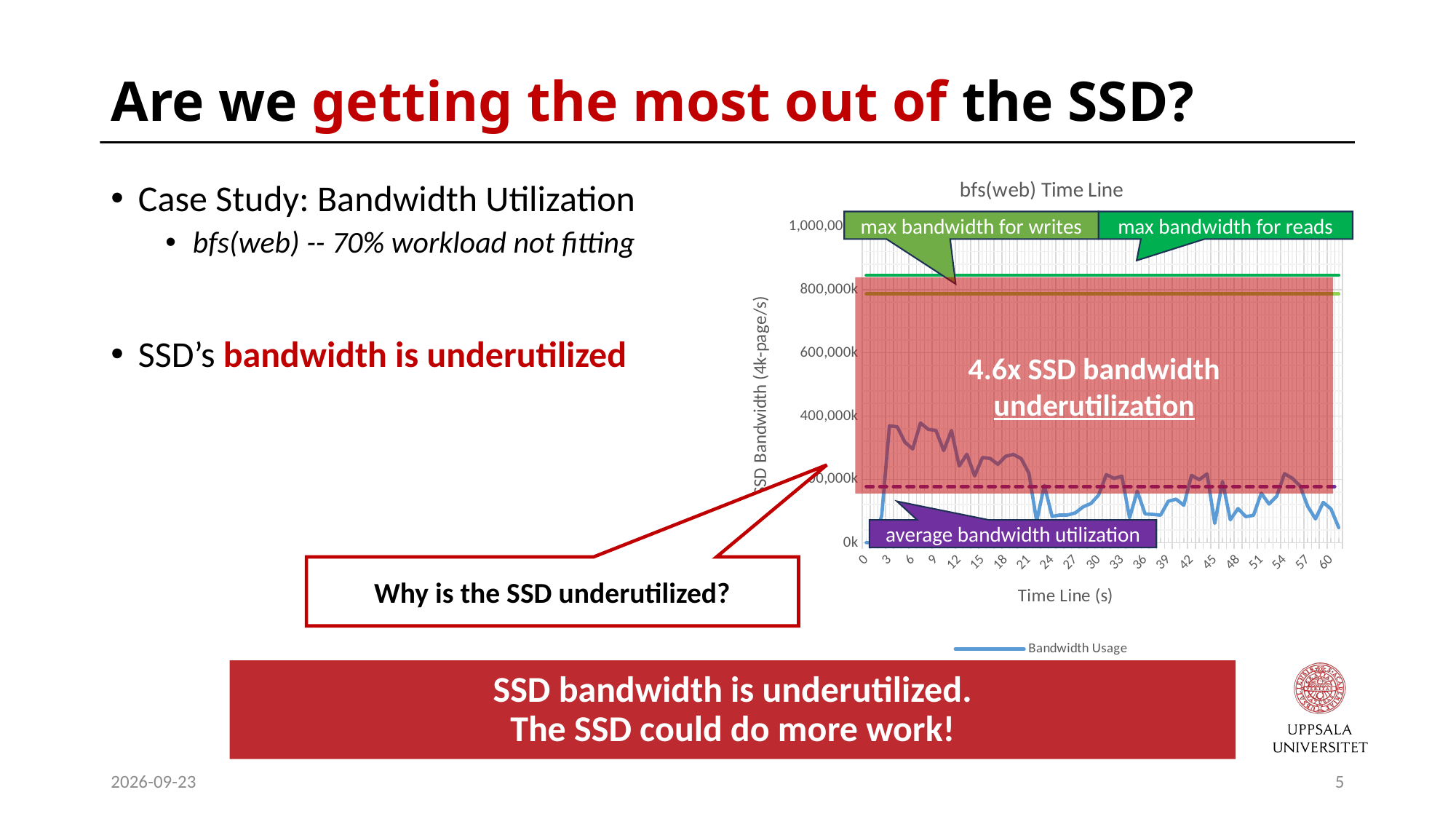
Is the Bandwidth Usage value at time 60 s greater or less than 200,000k? less What is the title of the chart? bfs(web) Time Line Is the Bandwidth Usage value at time 3 s greater or less than 200,000k? greater Is the 'max bandwidth for reads' line greater or less than 800,000k? greater Does the Bandwidth Usage line generally rise or fall from time 3 s to time 60 s? fall Which is higher on the chart, the max bandwidth for reads line or the max bandwidth for writes line? max bandwidth for reads What kind of chart is shown on the slide? line chart What is the label of the x axis of the chart? Time Line (s) How many series does the chart's legend list? 1 How many tick labels are shown on the x axis of the chart? 21 According to the annotation on the chart, by what factor is the SSD bandwidth underutilized? 4.6x